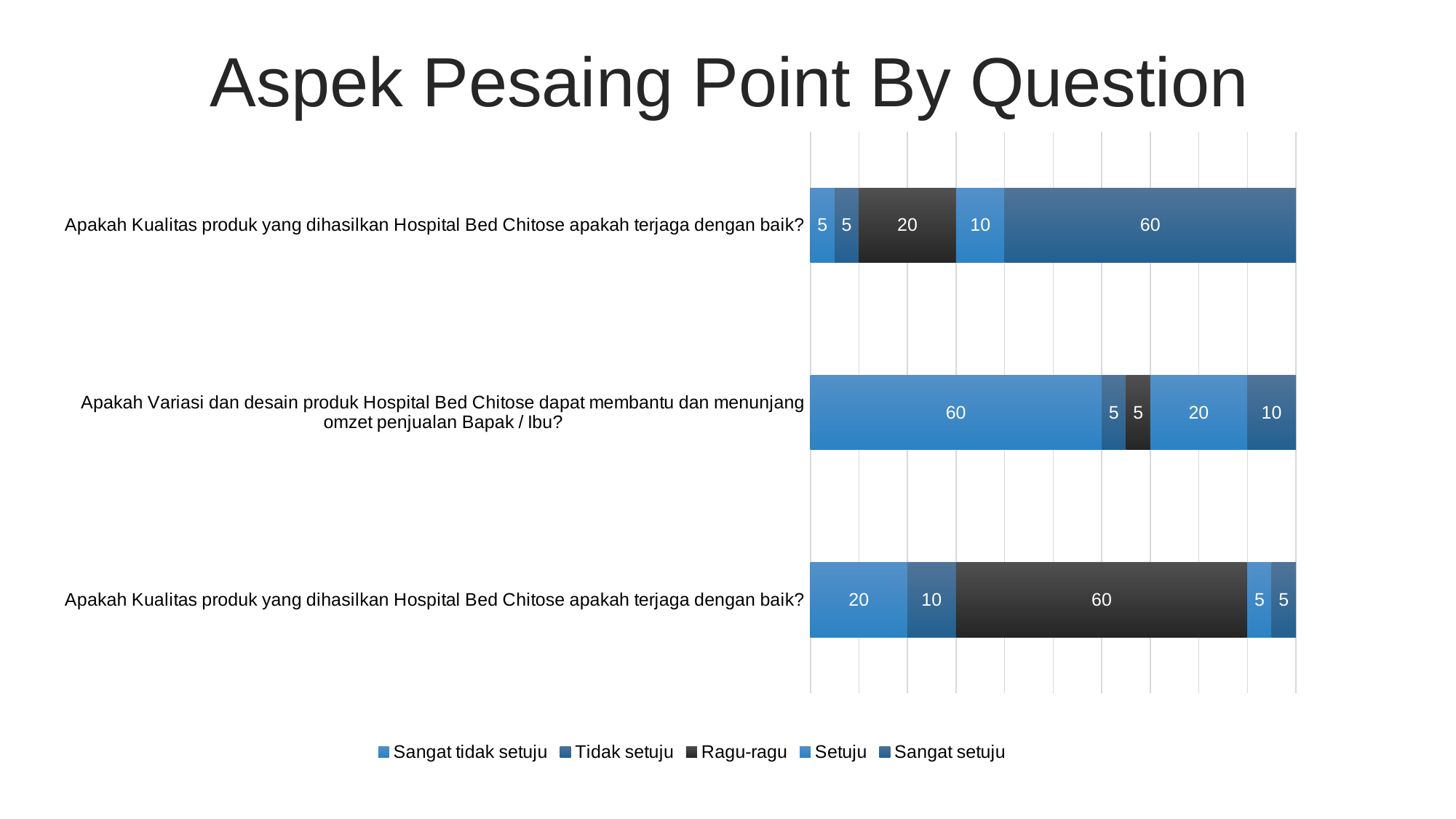
What is the value of 'Sangat setuju' for the top bar in the chart? 60 For the question 'Apakah Variasi dan desain produk Hospital Bed Chitose dapat membantu dan menunjang omzet penjualan Bapak / Ibu?', which series has the largest value? Sangat tidak setuju How many series does the legend list? 5 What kind of chart is shown on the slide? bar chart What is the value of 'Sangat tidak setuju' for the question 'Apakah Variasi dan desain produk Hospital Bed Chitose dapat membantu dan menunjang omzet penjualan Bapak / Ibu?'? 60 For the question 'Apakah Variasi dan desain produk Hospital Bed Chitose dapat membantu dan menunjang omzet penjualan Bapak / Ibu?', what is the difference between the 'Setuju' value and the 'Sangat setuju' value? 10 What is the value of 'Ragu-ragu' for the bottom bar in the chart? 60 What is the value of 'Ragu-ragu' for the question 'Apakah Variasi dan desain produk Hospital Bed Chitose dapat membantu dan menunjang omzet penjualan Bapak / Ibu?'? 5 How many bars (questions) are plotted in the chart? 3 What is the total of the stacked bar for the question 'Apakah Variasi dan desain produk Hospital Bed Chitose dapat membantu dan menunjang omzet penjualan Bapak / Ibu?'? 100 In the top bar of the chart, which is larger: the 'Ragu-ragu' value or the 'Setuju' value? Ragu-ragu What is the title of the chart on the slide? Aspek Pesaing Point By Question